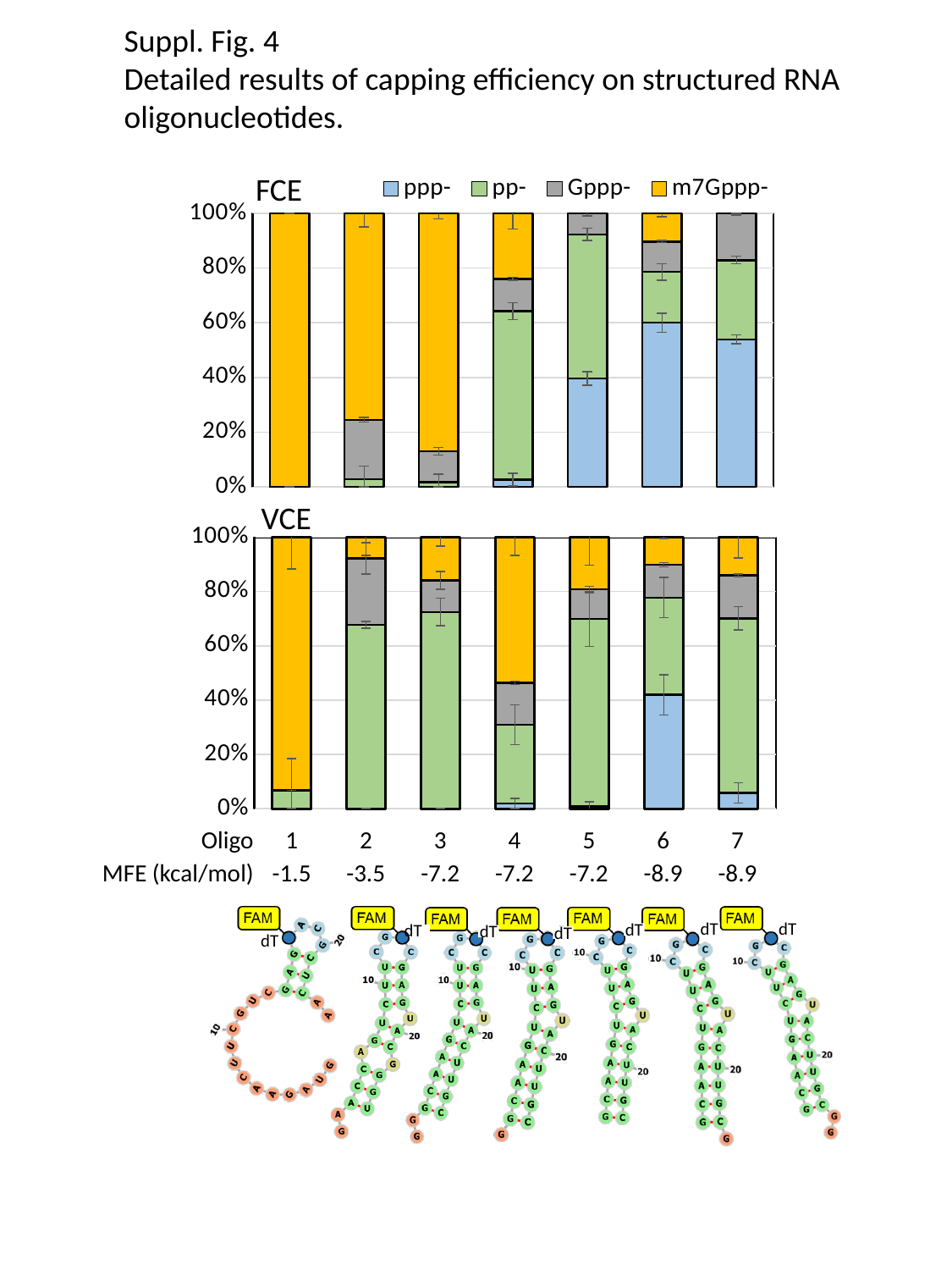
In the VCE chart, which oligo has the largest ppp- share? Oligo 6 What are the four legend entries shown above the FCE chart? ppp-, pp-, Gppp-, m7Gppp- In the VCE chart, is the pp- value for Oligo 2 greater or less than 60%? greater In the FCE chart, is the m7Gppp- value for Oligo 2 greater or less than 60%? greater In the FCE chart, is the m7Gppp- share larger for Oligo 2 or Oligo 7? Oligo 2 In the FCE chart, what is the total of the stacked bar for Oligo 1? 100% How many oligos are plotted along the x axis of the VCE chart? 7 In the FCE chart, which oligo has the largest ppp- share? Oligo 6 In the VCE chart, is the m7Gppp- value for Oligo 1 greater or less than 80%? greater What kind of chart is the FCE chart? stacked bar chart How many series does the legend list for the FCE and VCE charts? 4